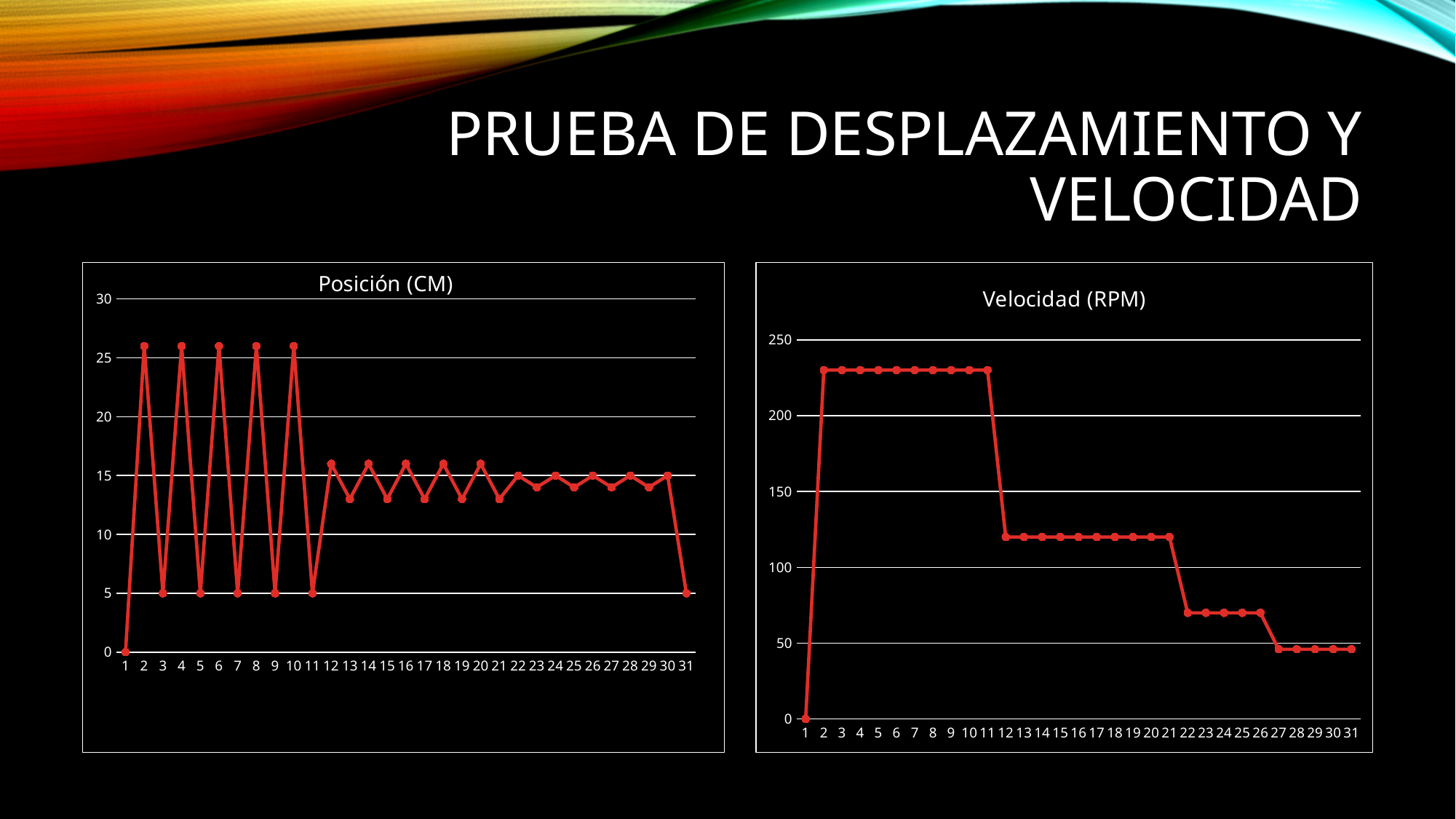
On the Posición (CM) chart, what is the value at point 1? 0 On the Velocidad (RPM) chart, is the value at point 15 greater or less than 150? less On the Velocidad (RPM) chart, is the value at point 29 greater or less than 100? less On the Velocidad (RPM) chart, do the values rise or fall from point 11 to point 31? fall How many data points are plotted on the Posición (CM) chart? 31 How many data points are plotted on the Velocidad (RPM) chart? 31 What kind of chart is the Posición (CM) chart? line chart On the Posición (CM) chart, what is the value at point 31? 5 What kind of chart is the Velocidad (RPM) chart? line chart On the Posición (CM) chart, what is the value at point 3? 5 On the Velocidad (RPM) chart, what is the value at point 1? 0 On the Velocidad (RPM) chart, is the value at point 5 greater or less than 200? greater